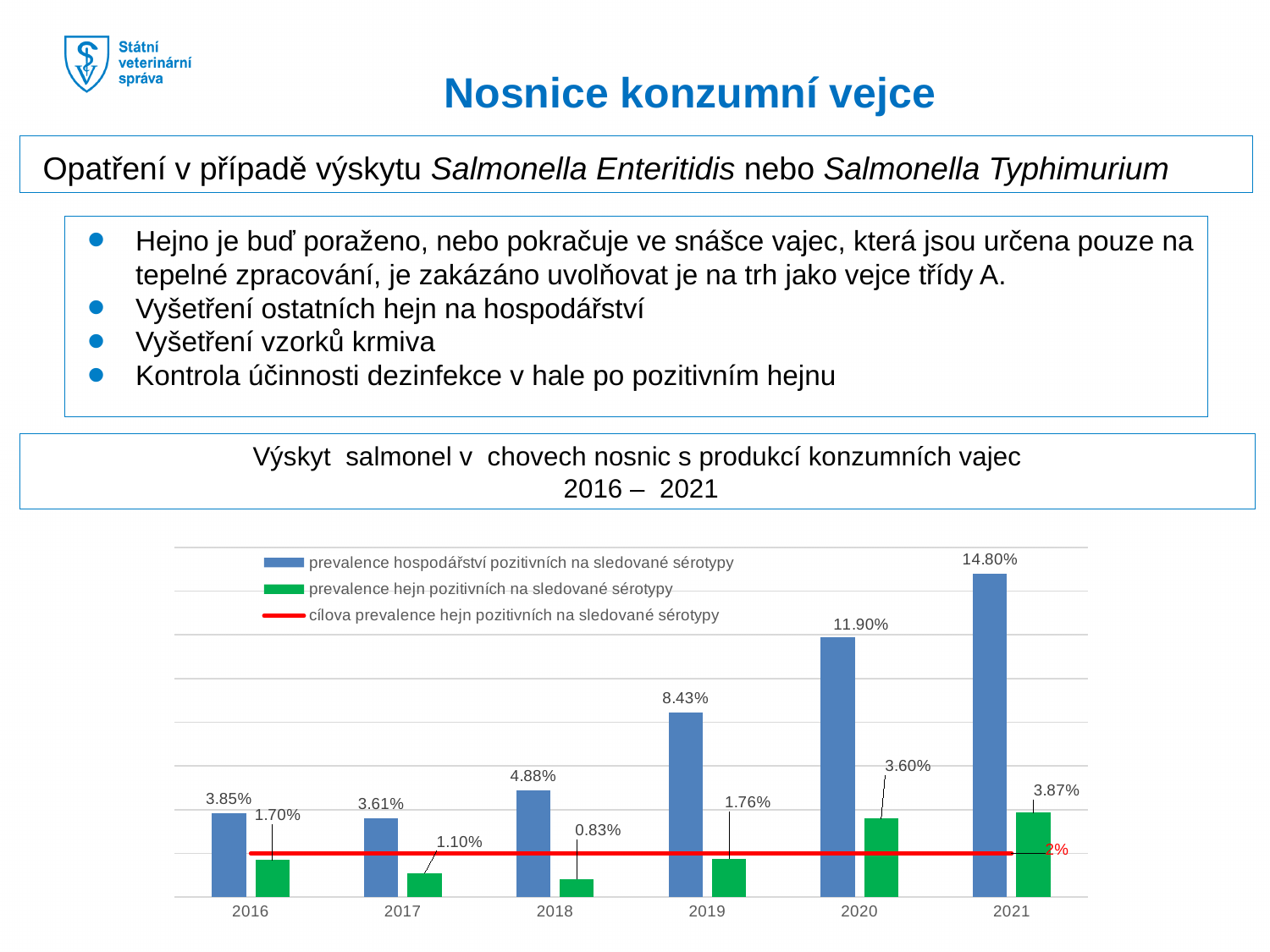
What value does the red line 'cílova prevalence hejn pozitivních na sledované sérotypy' mark? 2% What is the value of 'prevalence hospodářství pozitivních na sledované sérotypy' for 2019? 8.43% Which is larger: 'prevalence hejn pozitivních na sledované sérotypy' in 2016 or in 2017? 2016 In which year is 'prevalence hospodářství pozitivních na sledované sérotypy' highest? 2021 How many years are shown on the x axis of the chart? 6 What is the value of 'prevalence hejn pozitivních na sledované sérotypy' for 2018? 0.83% What is the value of 'prevalence hejn pozitivních na sledované sérotypy' for 2020? 3.60% What kind of chart is shown on the slide? combination bar and line chart In which year is 'prevalence hejn pozitivních na sledované sérotypy' lowest? 2018 What is the value of 'prevalence hospodářství pozitivních na sledované sérotypy' for 2021? 14.80% What is the difference between 'prevalence hospodářství pozitivních na sledované sérotypy' in 2021 and in 2020? 2.90% How many series does the chart legend list? 3